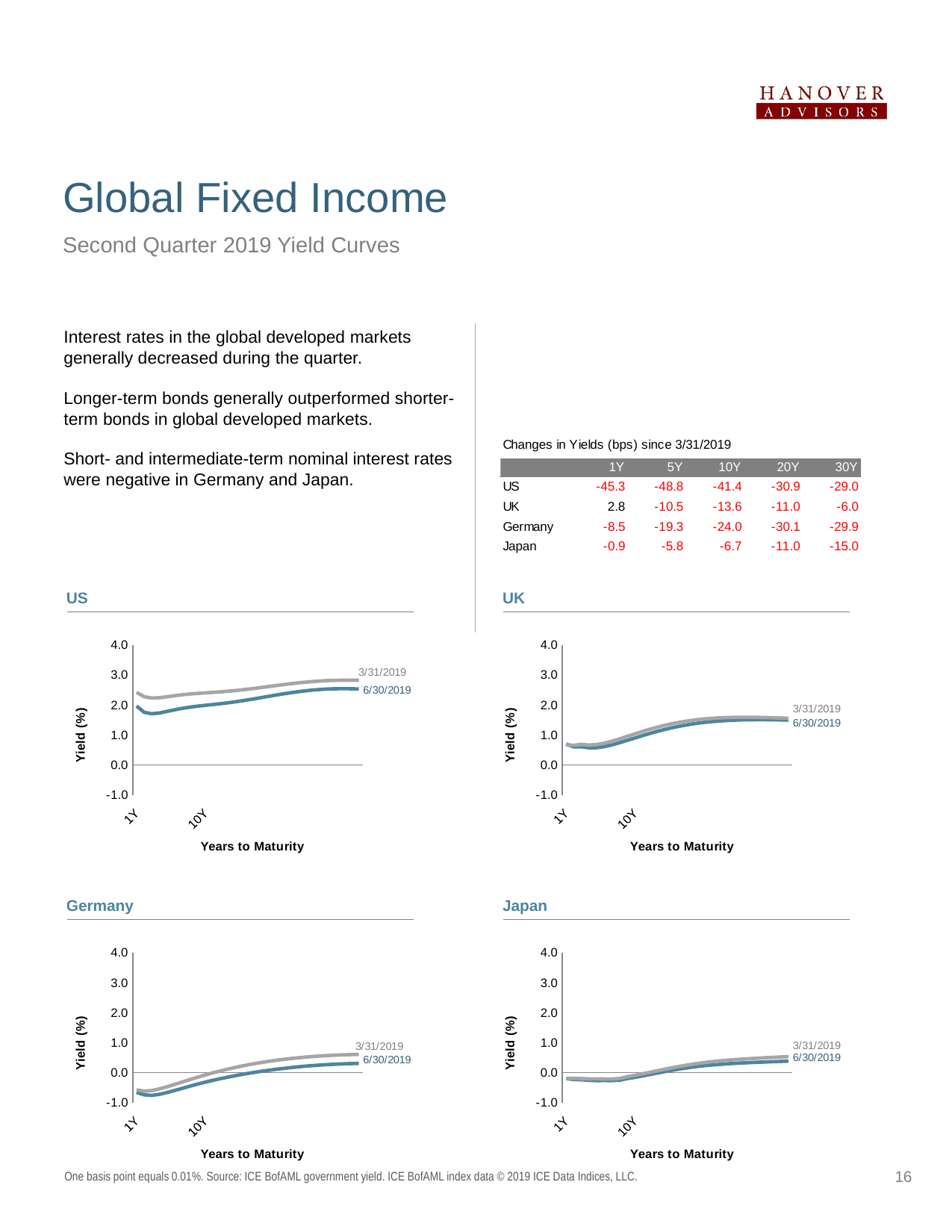
What is the y-axis label on the Japan chart? Yield (%) On the Germany chart, is the 6/30/2019 value at 1Y greater or less than 0.0? less On the Germany chart, which series is higher at 10Y, 3/31/2019 or 6/30/2019? 3/31/2019 On the US chart, which series is higher at 1Y, 3/31/2019 or 6/30/2019? 3/31/2019 How many yield curve charts are shown on the slide? 4 On the US chart, is the 3/31/2019 value at 10Y greater or less than 2.0? greater On the Japan chart, is the 3/31/2019 value at 1Y greater or less than 0.0? less On the UK chart, does the 3/31/2019 line rise or fall as years to maturity increase? rise How many series does the US chart show? 2 What kind of chart is the US chart? line chart On the Germany chart, does the 6/30/2019 line rise or fall as years to maturity increase? rise